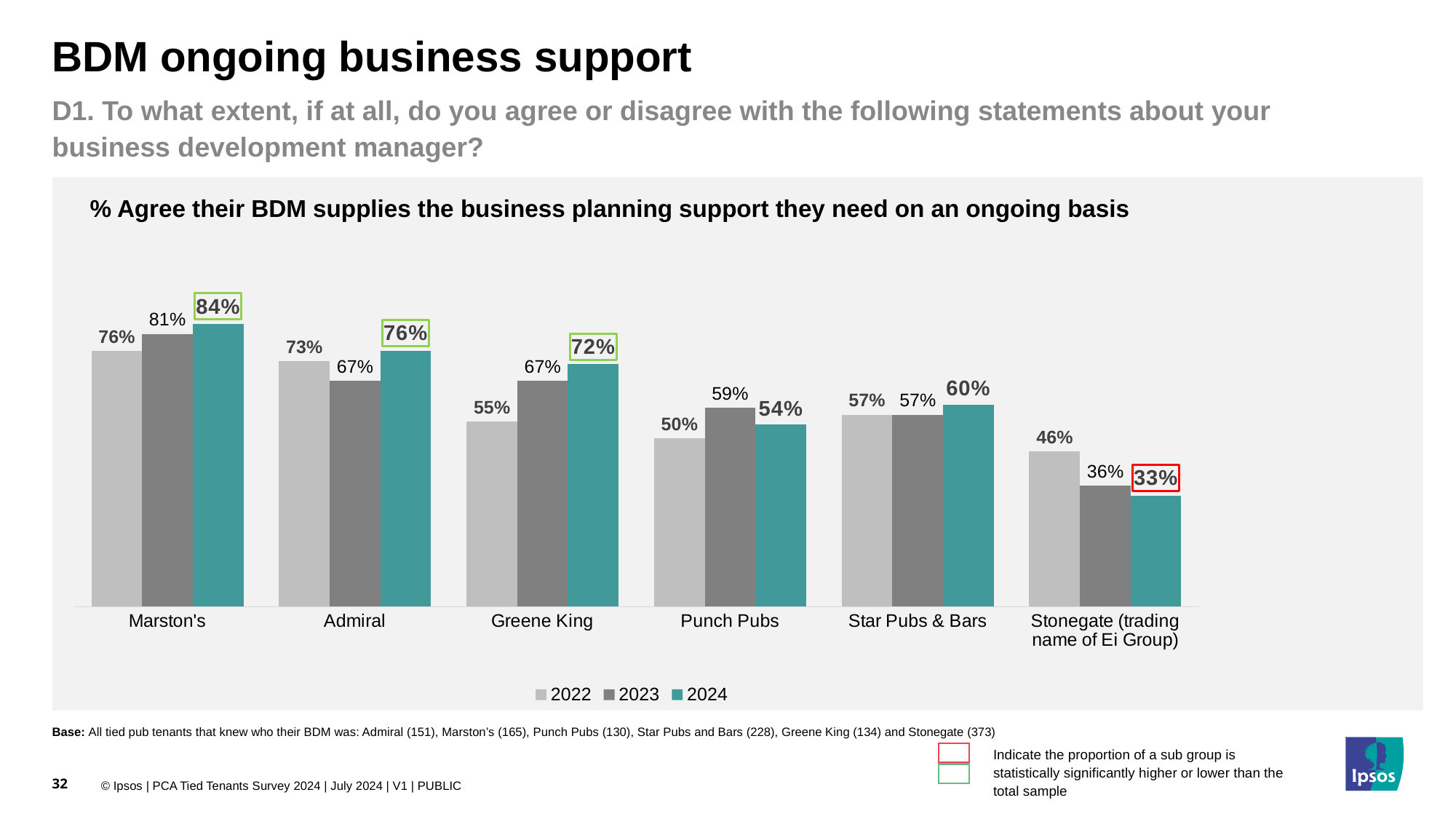
Which is larger for Punch Pubs, the 2023 value or the 2024 value? 2023 How many pub companies are shown on the x axis? 6 What is the 2023 value for Admiral? 67% Which pub company has the lowest 2024 value? Stonegate (trading name of Ei Group) What is the 2024 value for Marston's? 84% How many series does the legend list? 3 What is the 2022 value for Stonegate (trading name of Ei Group)? 46% Which pub company has the highest 2024 value? Marston's What is the title of the chart? % Agree their BDM supplies the business planning support they need on an ongoing basis What is the difference between the 2024 and 2022 values for Greene King? 17 percentage points Do the values for Stonegate (trading name of Ei Group) rise or fall from 2022 to 2024? Fall What kind of chart is shown on the slide? Bar chart